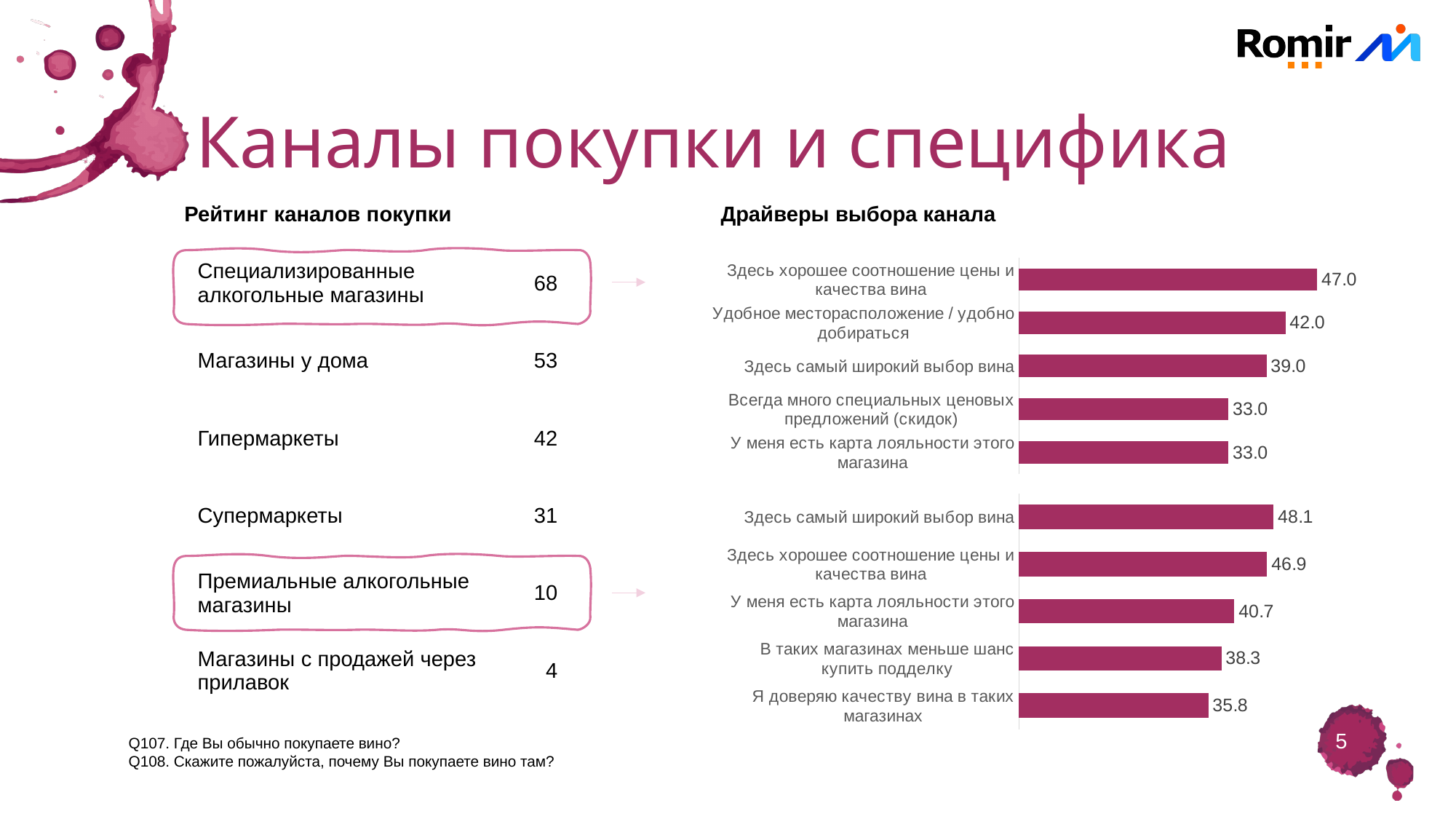
What kind of chart is shown under the heading "Драйверы выбора канала"? bar chart In the "Драйверы выбора канала" chart, which category has the lowest value in the lower group of bars? Я доверяю качеству вина в таких магазинах In the "Драйверы выбора канала" chart, which category has the highest value in the upper group of bars? Здесь хорошее соотношение цены и качества вина In the "Драйверы выбора канала" chart, what is the value for "Здесь хорошее соотношение цены и качества вина" in the upper group of bars? 47.0 In the "Драйверы выбора канала" chart, what is the value for "Здесь самый широкий выбор вина" in the lower group of bars? 48.1 In the "Драйверы выбора канала" chart, what is the difference between "Здесь хорошее соотношение цены и качества вина" (47.0) and "Всегда много специальных ценовых предложений (скидок)" (33.0) in the upper group? 14.0 How many bars are shown in the upper group of the "Драйверы выбора канала" chart? 5 In the "Драйверы выбора канала" chart, what is the value for "Удобное месторасположение / удобно добираться"? 42.0 In the "Драйверы выбора канала" chart, which is larger: "Удобное месторасположение / удобно добираться" or "У меня есть карта лояльности этого магазина" in the lower group? Удобное месторасположение / удобно добираться In the "Драйверы выбора канала" chart, what is the value for "В таких магазинах меньше шанс купить подделку"? 38.3 How many bars are shown in total in the "Драйверы выбора канала" chart? 10 In the "Драйверы выбора канала" chart, what is the difference between "Здесь самый широкий выбор вина" in the lower group (48.1) and "Здесь самый широкий выбор вина" in the upper group (39.0)? 9.1